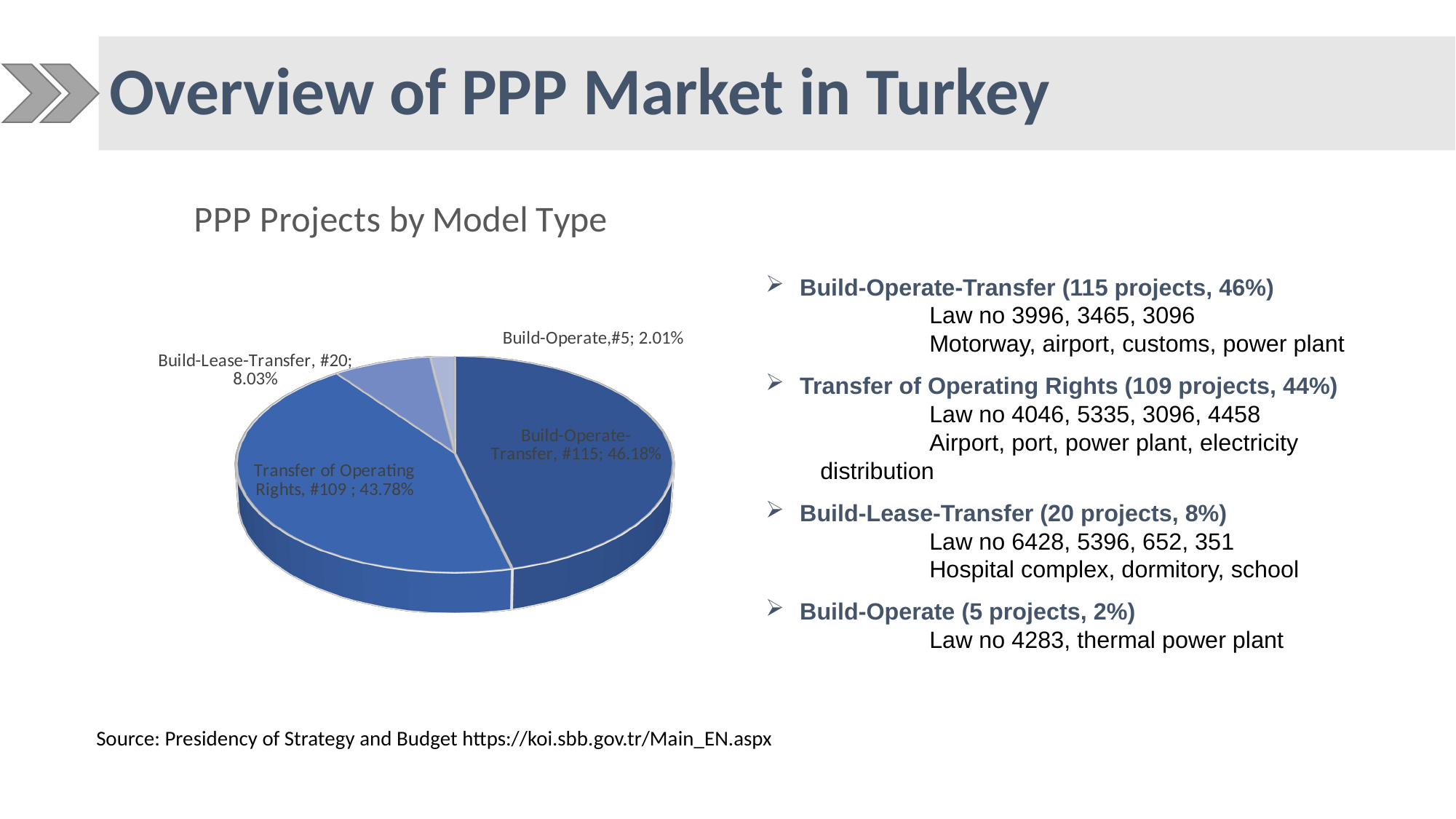
How many projects are shown for Transfer of Operating Rights in the chart? 109 How many projects are shown for Build-Lease-Transfer in the chart? 20 What is the difference in number of projects between Build-Operate-Transfer and Build-Operate? 110 What share of the pie does Build-Operate represent? 2.01% What share of the pie does Build-Lease-Transfer represent? 8.03% What share of the pie does Build-Operate-Transfer represent? 46.18% How many slices does the pie chart have? 4 What type of chart is shown on the slide? Pie chart What is the title of the chart? PPP Projects by Model Type Which model type has the smallest slice of the pie? Build-Operate Which model type has the largest slice of the pie? Build-Operate-Transfer